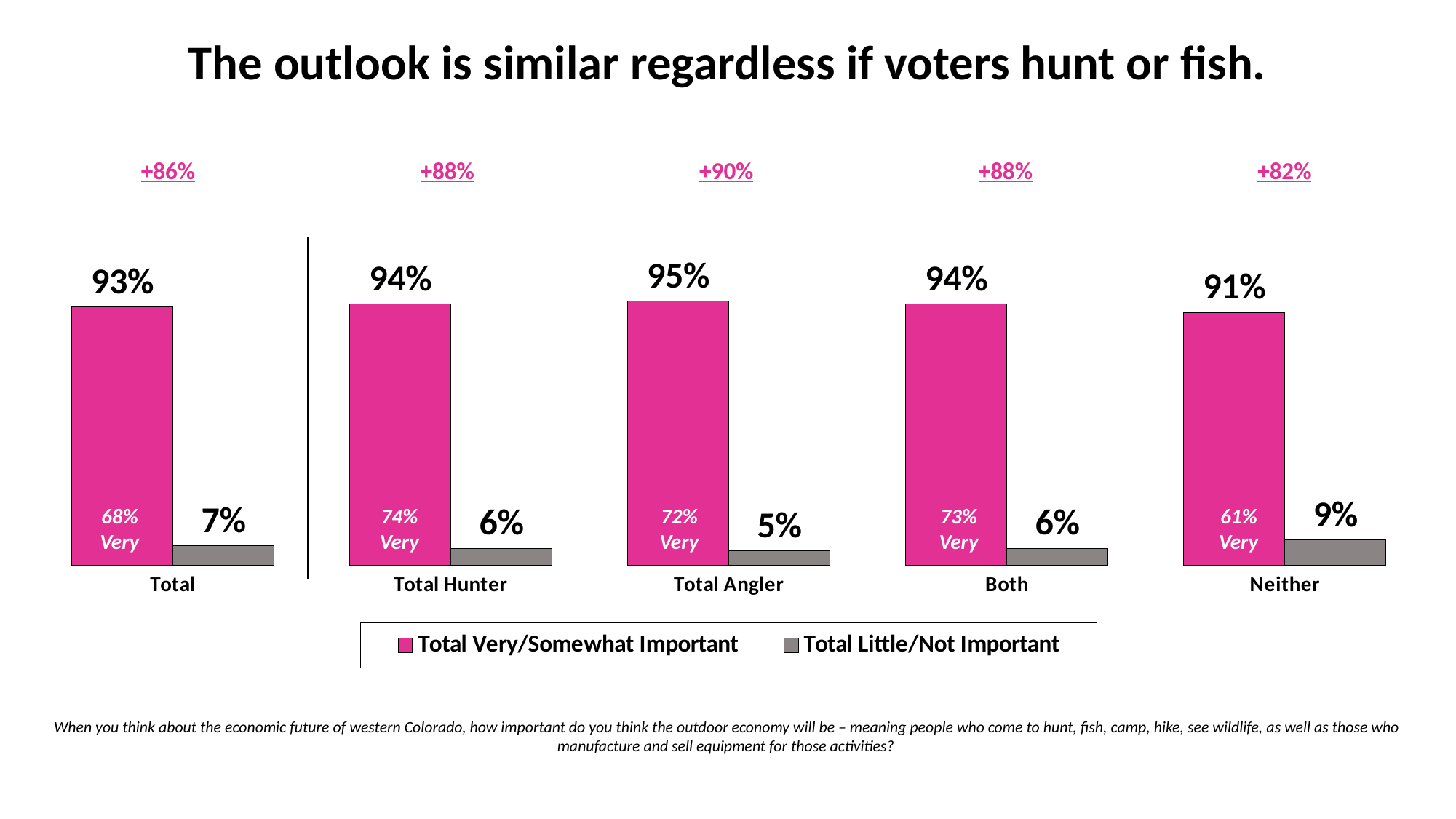
What kind of chart is shown on the slide? Bar chart What is the Total Little/Not Important value for Neither? 9% What is the Total Very/Somewhat Important value for Total Angler? 95% Which category has the highest Total Very/Somewhat Important value? Total Angler What is the difference between the Total Very/Somewhat Important and Total Little/Not Important values for Total? 86% What colour are the Total Very/Somewhat Important bars? Pink Which category has the lowest Total Very/Somewhat Important value? Neither How many series does the legend list? 2 What percentage of Total Hunter respondents said 'Very' important? 74% What is the net figure shown above the Both category? +88% How many categories are shown on the x axis? 5 Which is larger, the Total Little/Not Important value for Neither or for Total Angler? Neither